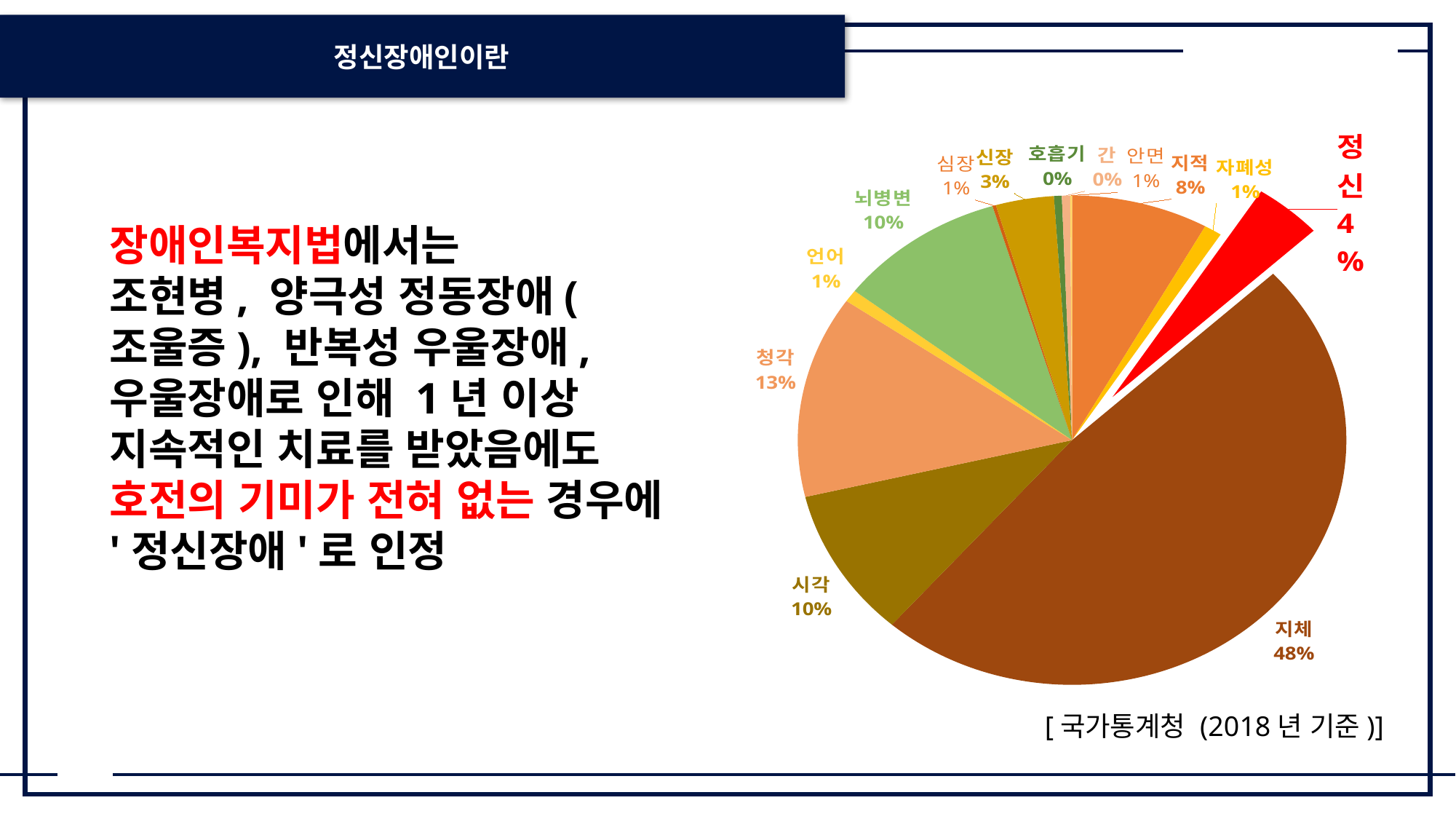
Which is larger, the share for 청각 or the share for 뇌병변? 청각 What is the difference between the share for 지적 and the share for 정신? 4% What percentage does the 정신 slice represent? 4% What percentage does the 청각 slice represent? 13% What percentage does the 지체 slice represent? 48% What kind of chart is shown on the slide? pie chart What is the source cited below the pie chart? 국가통계청 (2018년 기준) How many categories are shown in the pie chart? 13 What percentage does the 지적 slice represent? 8% What percentage does the 신장 slice represent? 3% What is the difference between the share for 지체 and the share for 청각? 35% Which category has the largest share of the pie? 지체